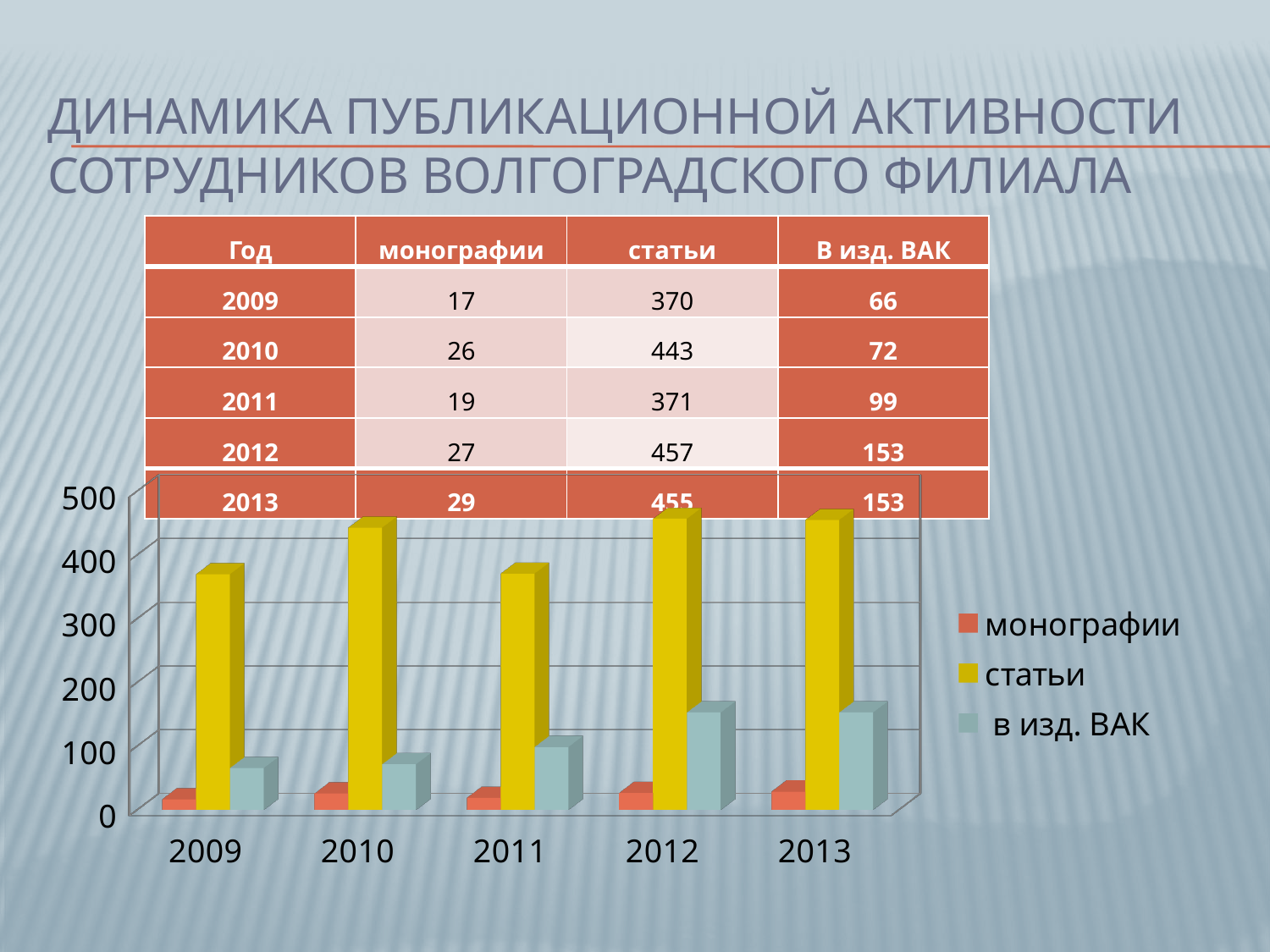
How many years are shown on the x axis of the chart? 5 According to the table, what is the value for монографии in 2013? 29 Is the value for статьи in 2011 greater or less than 400? less Which is larger: the В изд. ВАК value for 2010 or for 2011? 2011 What is the difference between the статьи values for 2010 and 2009? 73 How many series does the chart legend list? 3 In which year is the value for статьи the highest? 2012 According to the table, what is the value for статьи in 2012? 457 Which series is shown in yellow in the chart? статьи According to the table, what is the value for В изд. ВАК in 2011? 99 In which year is the value for монографии the lowest? 2009 What kind of chart is shown on the slide? bar chart